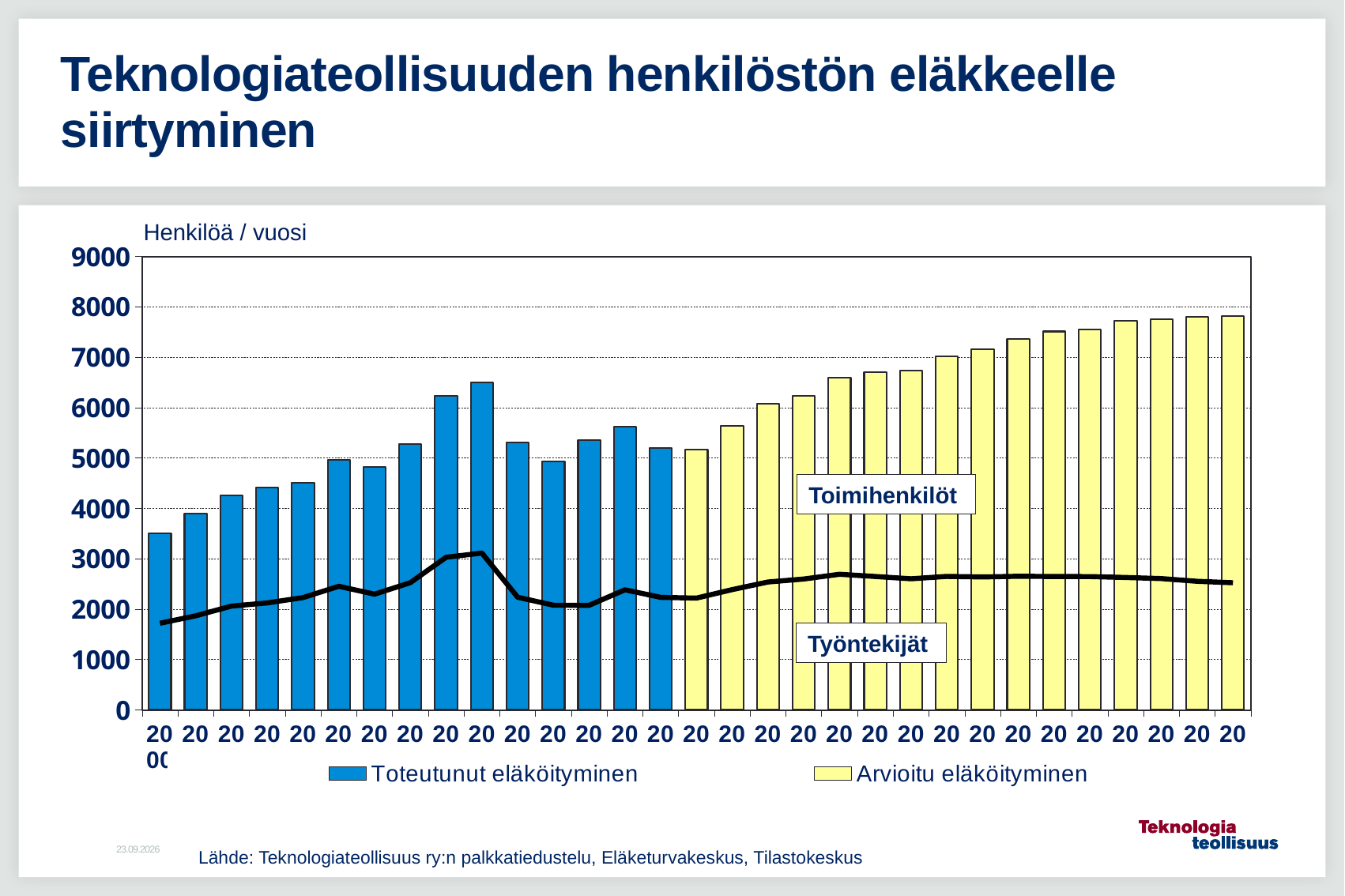
How many series does the legend list? 2 Which series contains the tallest bar on the chart, Toteutunut eläköityminen or Arvioitu eläköityminen? Arvioitu eläköityminen Is the value of the black line at the leftmost point greater or less than 2000? less Is the first (leftmost) blue bar greater or less than 4000? less Is the tallest blue bar (Toteutunut eläköityminen) greater or less than 6000? greater Do the yellow Arvioitu eläköityminen bars generally rise or fall from left to right? rise Which series is drawn with blue bars? Toteutunut eläköityminen What kind of chart is shown on the slide? bar and line chart What is the label shown above the vertical axis? Henkilöä / vuosi How many blue Toteutunut eläköityminen bars are plotted? 15 What are the two series named in the legend? Toteutunut eläköityminen and Arvioitu eläköityminen